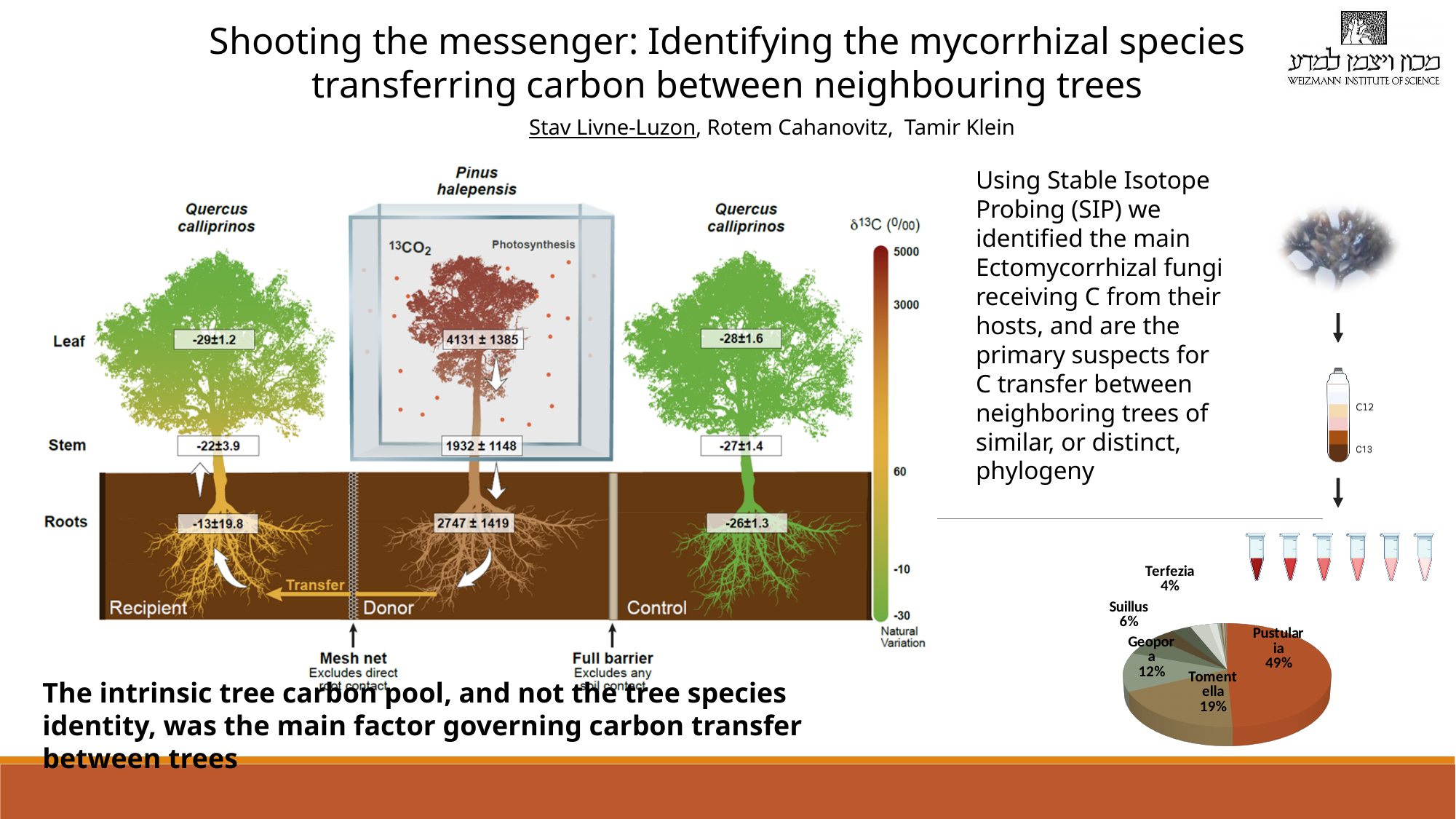
In the pie chart, what is the difference in percentage points between Pustularia and Tomentella? 30% In the pie chart, which has the larger share, Geopora or Suillus? Geopora What kind of chart is shown at the bottom right of the slide? pie chart In the pie chart, which has the larger share, Suillus or Terfezia? Suillus In the pie chart, what percentage is shown for Pustularia? 49% In the pie chart, what percentage is shown for Suillus? 6% In the pie chart, which fungus has the largest slice? Pustularia In the pie chart, what percentage is shown for Tomentella? 19% In the pie chart, what percentage is shown for Geopora? 12% In the pie chart, what percentage is shown for Terfezia? 4% In the pie chart, what share of the pie does Pustularia take? 49% In the pie chart, what is the difference in percentage points between Tomentella and Geopora? 7%